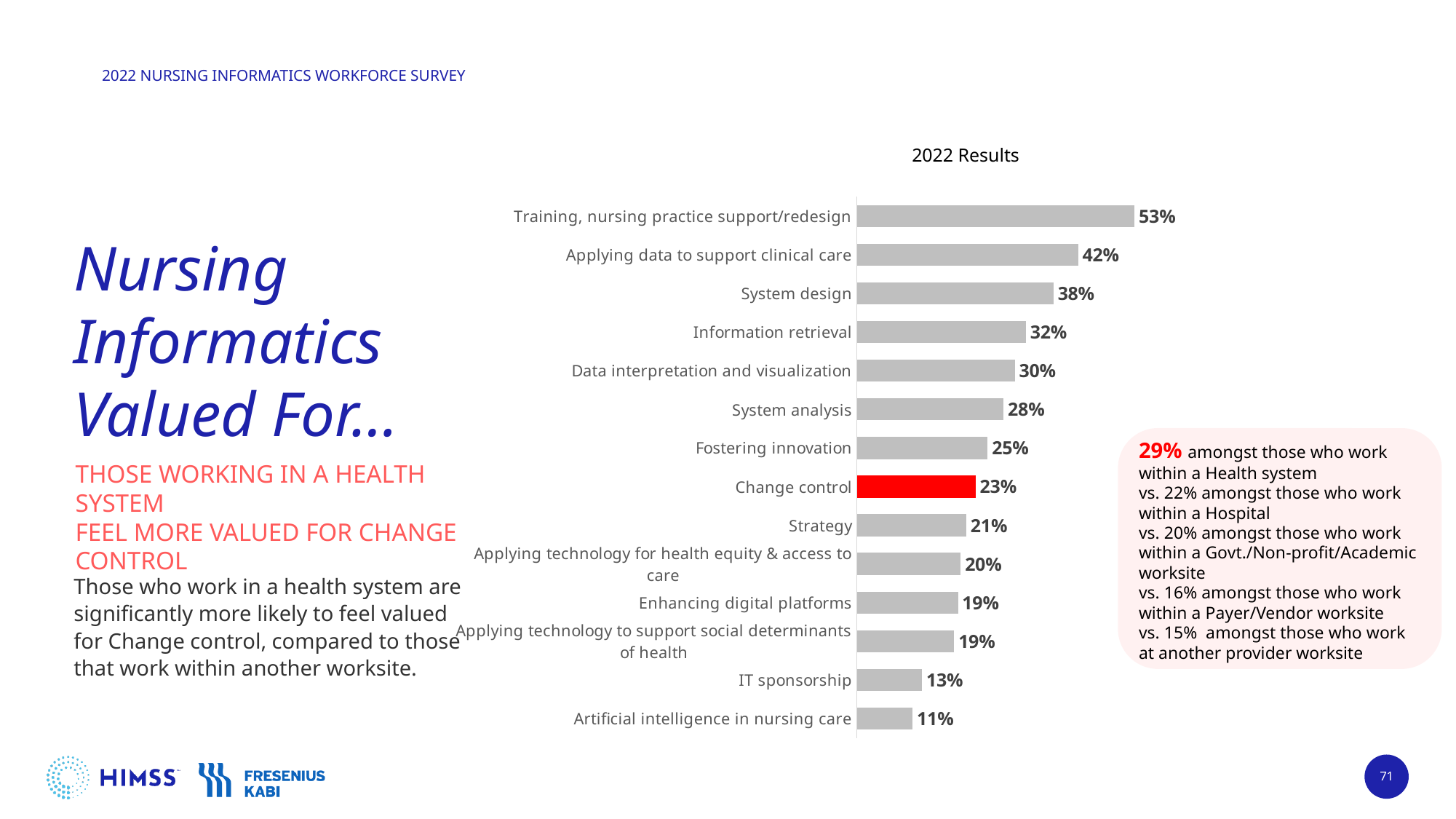
What is the difference between Applying data to support clinical care and System design? 4% What is the title of the chart? 2022 Results Which is larger, Information retrieval or Fostering innovation? Information retrieval What kind of chart is shown on the slide? Bar chart Which category has the lowest value? Artificial intelligence in nursing care What is the difference between Training, nursing practice support/redesign and Artificial intelligence in nursing care? 42% What is the value for Training, nursing practice support/redesign? 53% How many categories are shown in the chart? 14 Which bar is highlighted in red? Change control What is the value for Change control? 23% What is the value for Artificial intelligence in nursing care? 11% Which category has the highest value? Training, nursing practice support/redesign